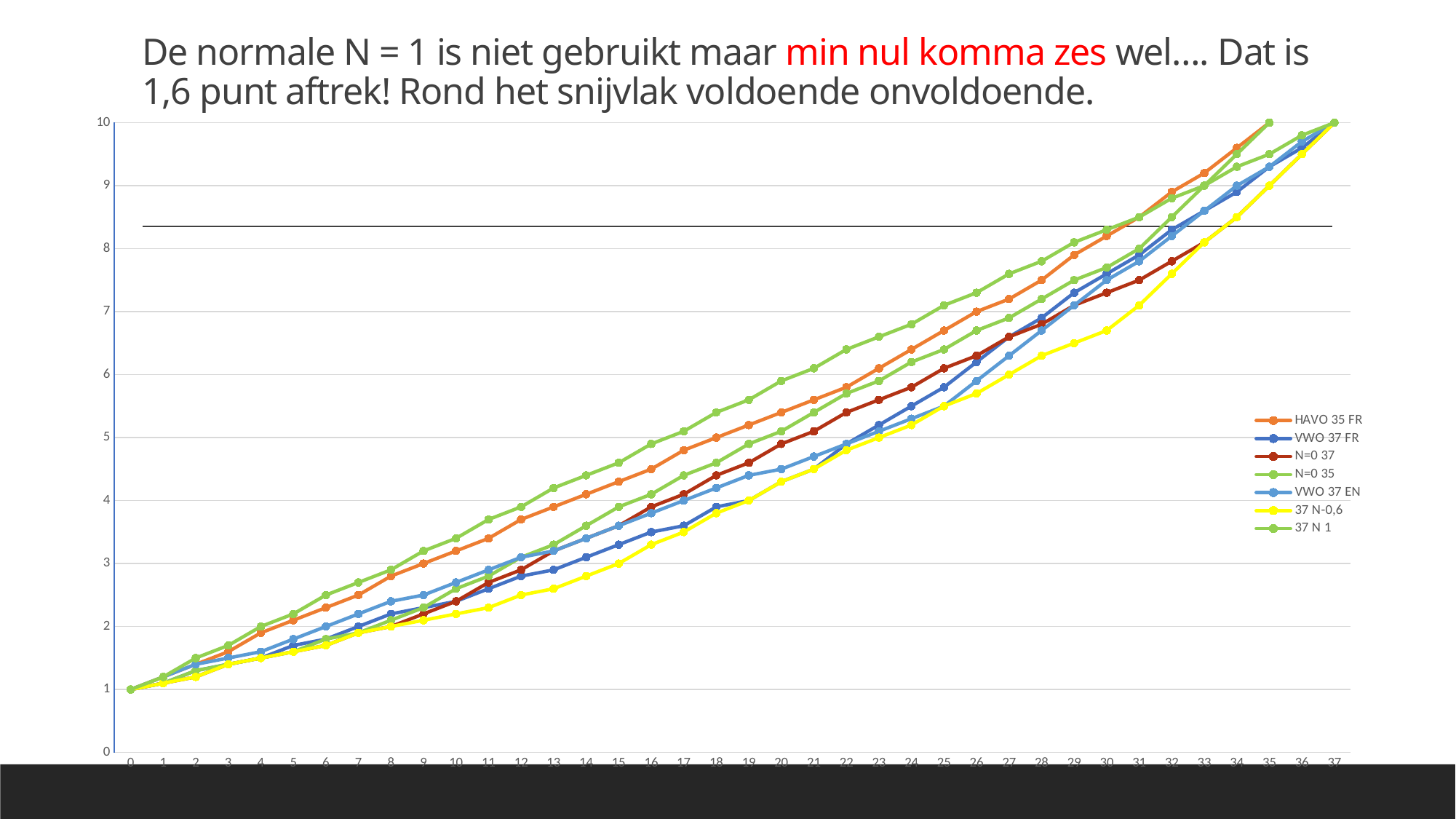
Is the value of the VWO 37 FR series at x = 25 greater or less than 5? greater What is the value of the HAVO 35 FR series at x = 35? 10 What is the value of the 37 N-0,6 series at x = 37? 10 At x = 30, which is higher: N=0 35 or 37 N-0,6? N=0 35 Is the value of the 37 N-0,6 series at x = 30 greater or less than 7? less What is the value of the HAVO 35 FR series at x = 0? 1 Is the value of the HAVO 35 FR series at x = 15 greater or less than 4? greater What is the highest value shown on the vertical axis? 10 What kind of chart is shown on the slide? line chart At x = 30, which series has the lowest value? 37 N-0,6 How many series does the legend list? 7 Do the values of the series rise or fall as x increases from 0 to 37? rise